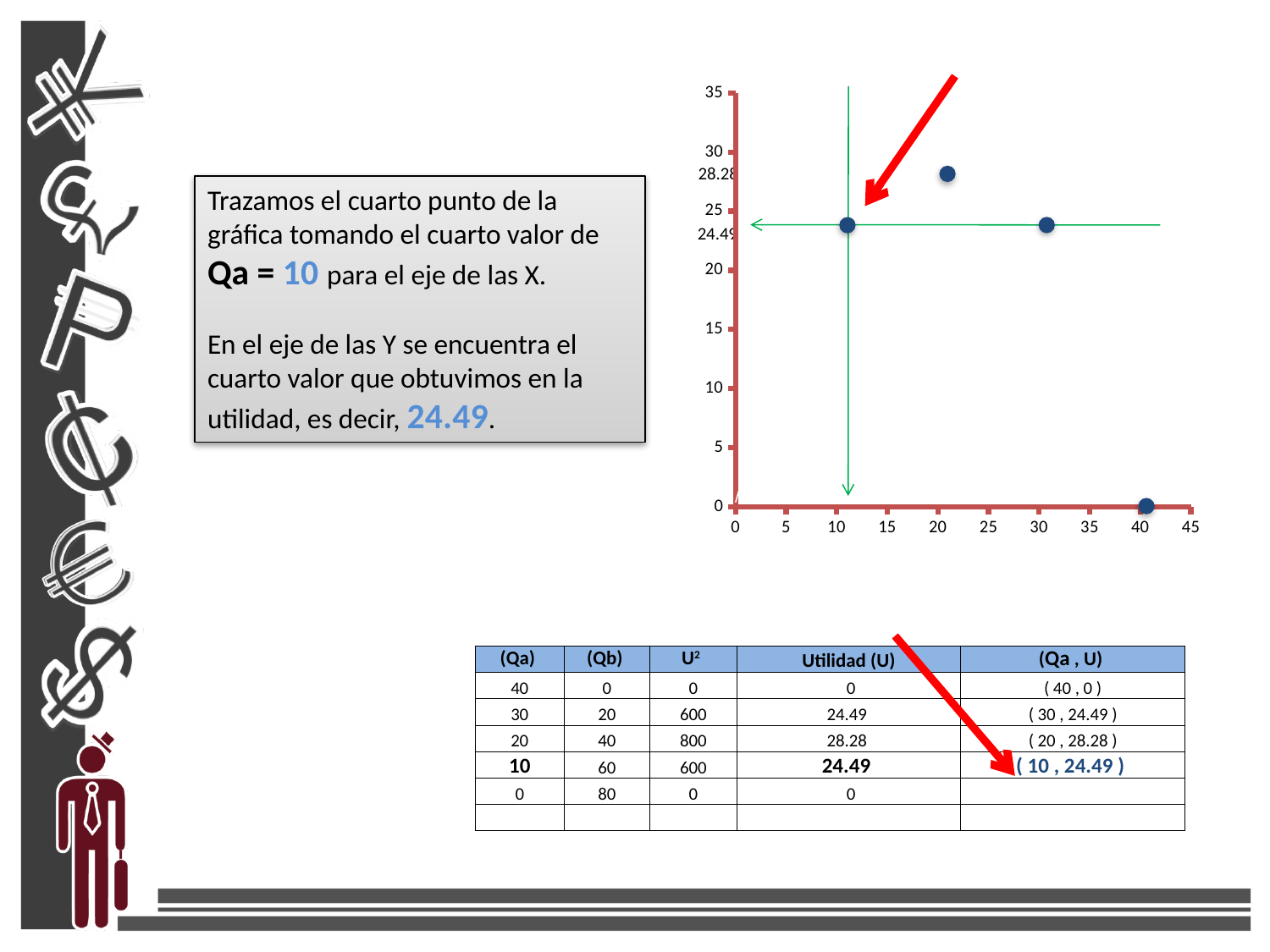
Is the utility value for the point at Qa = 30 greater or less than 20? greater Which plotted point has a higher utility value, the one at Qa = 20 or the one at Qa = 30? Qa = 20 What is the highest tick label shown on the x axis of the chart? 45 What is the utility (U) value plotted for Qa = 40? 0 What is the utility (U) value plotted for Qa = 20? 28.28 What kind of chart is shown on the slide? scatter chart At which Qa value does the plotted point have the highest utility? 20 Is the utility value for the point at Qa = 20 greater or less than 25? greater What is the difference between the utility at Qa = 20 and the utility at Qa = 30? 3.79 What is the utility (U) value plotted for Qa = 10? 24.49